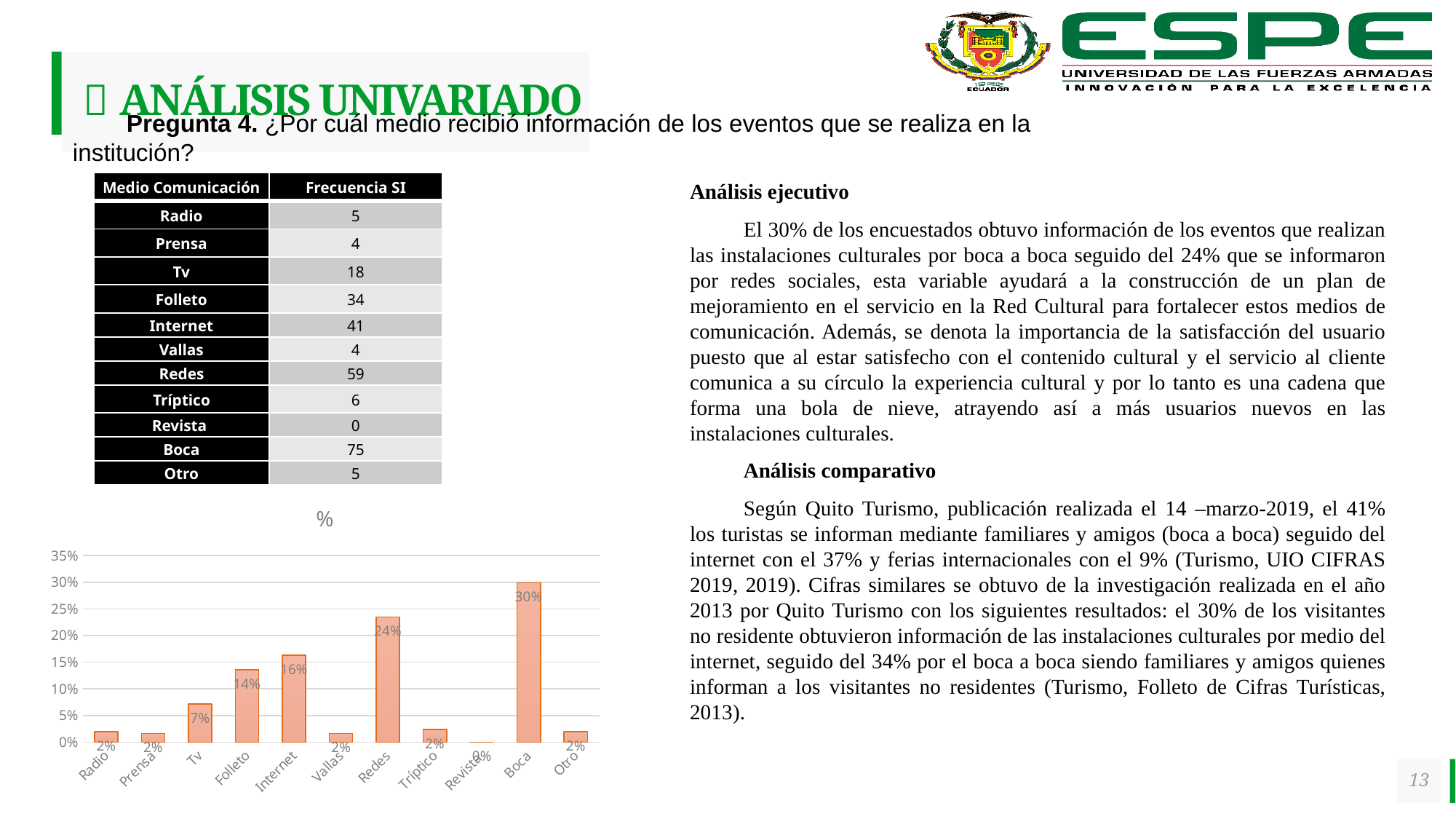
Which category has the lowest value in the chart? Revista What kind of chart is shown on the slide? bar chart Which category has the highest value in the chart? Boca Which is larger, the value for Tv or the value for Folleto? Folleto What is the title of the chart? % What is the value shown for Internet in the chart? 16% How many categories are plotted on the x axis of the chart? 11 What is the value shown for Folleto in the chart? 14% What is the value shown for Redes in the chart? 24% What is the value shown for Boca in the chart? 30% Is the value for Redes greater or less than 20%? greater What is the difference between the values for Boca and Redes? 6%